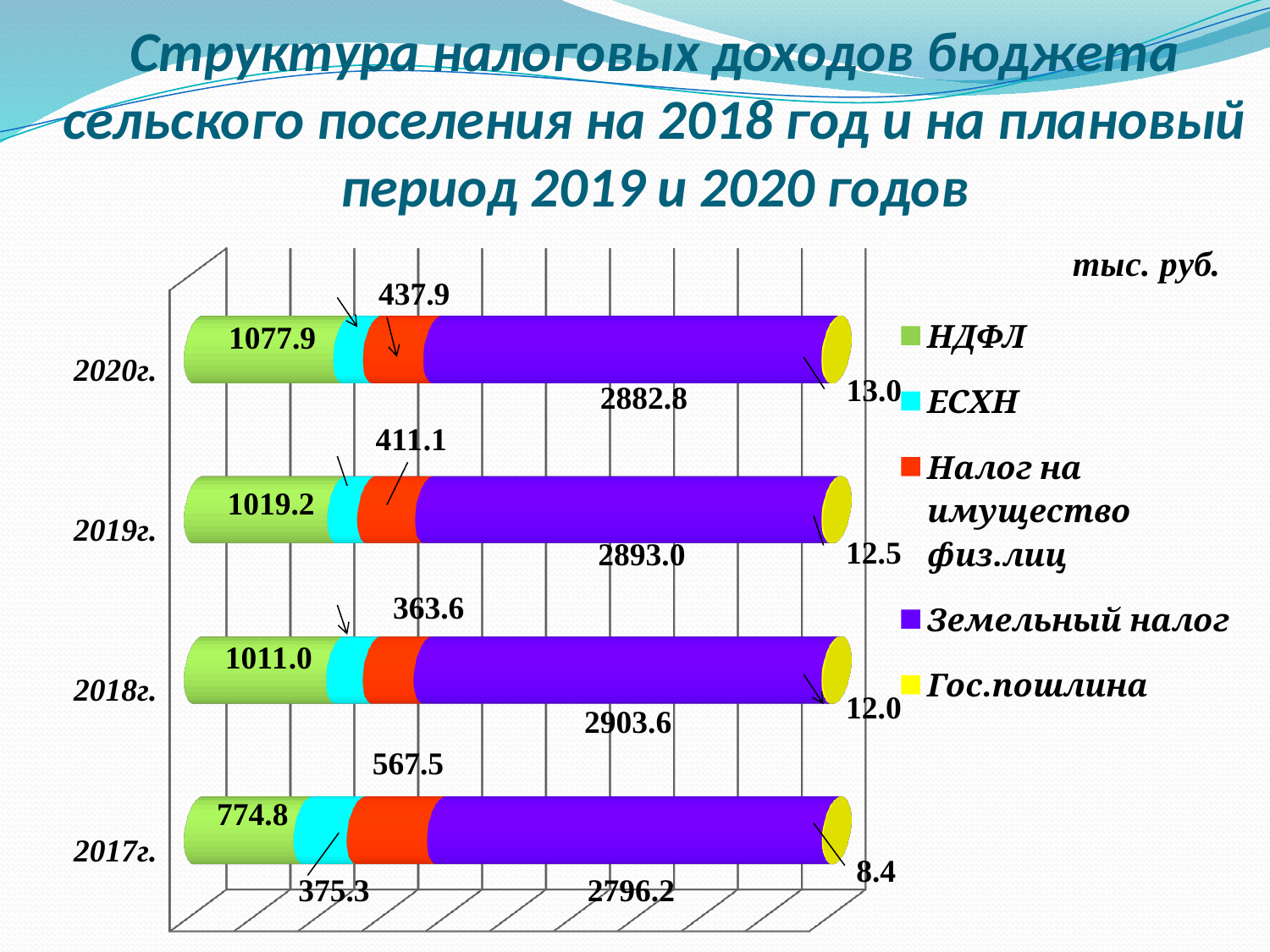
What is the total of the stacked bar for 2017г.? 4522.2 What is the value of Гос.пошлина for 2017г.? 8.4 How many series does the legend list? 5 How many years are shown on the chart? 4 What is the value of Налог на имущество физ.лиц for 2019г.? 411.1 What is the value of НДФЛ for 2020г.? 1077.9 What is the difference between НДФЛ in 2020г. and in 2019г.? 58.7 What kind of chart is shown on the slide? Stacked bar chart In which year is Земельный налог the highest? 2018г. Which is larger: Налог на имущество физ.лиц in 2017г. or in 2020г.? 2017г. What is the value of Земельный налог for 2018г.? 2903.6 In which year is НДФЛ the lowest? 2017г.